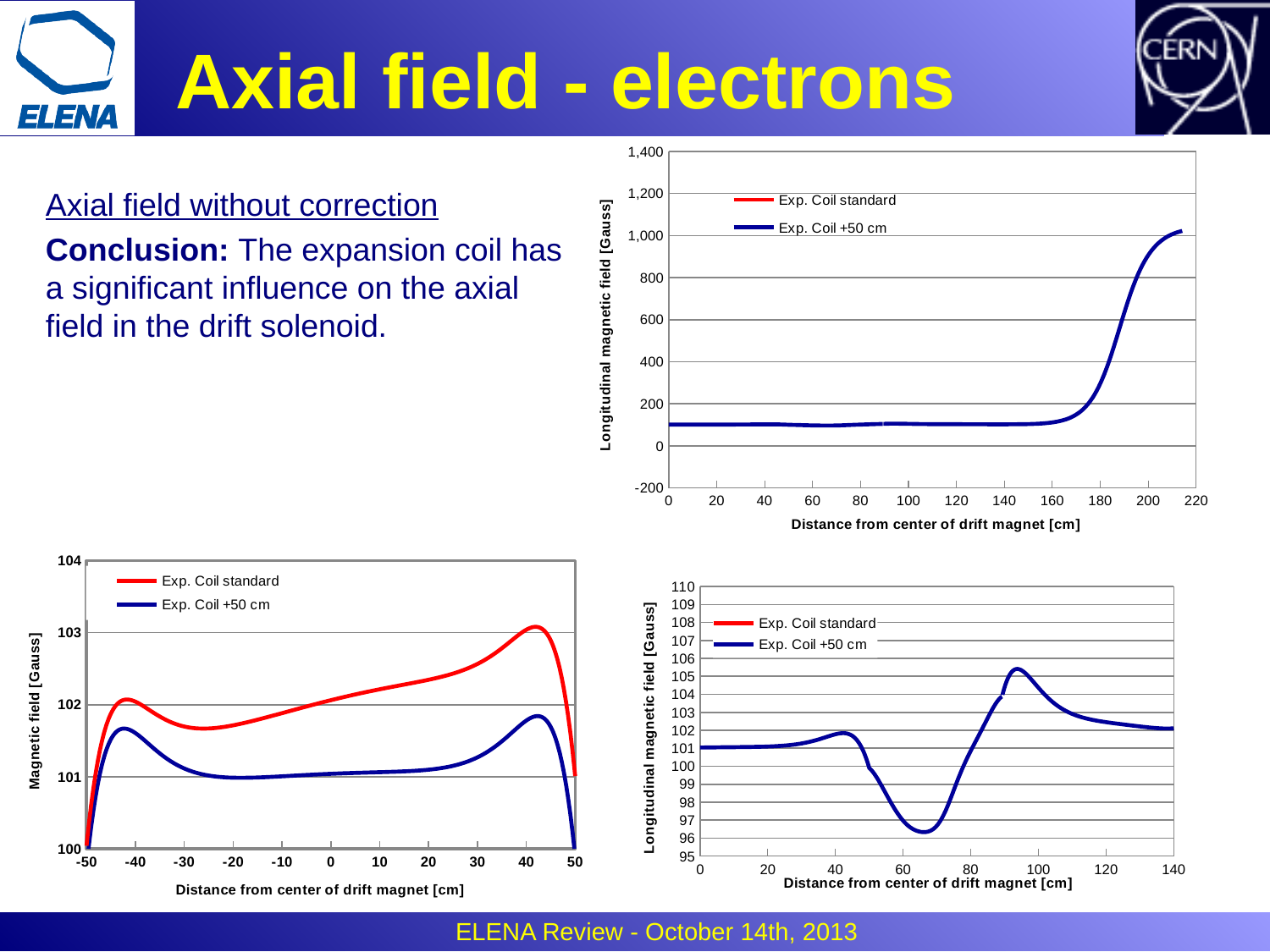
In the bottom-right chart, is the value at 60 cm greater or less than 100? less In the bottom-left chart, does the Exp. Coil standard line rise or fall between -20 cm and 40 cm? rise In the bottom-left chart, is the value of the Exp. Coil +50 cm line at 0 cm greater or less than 102? less In the bottom-right chart, does the curve rise or fall between 70 cm and 90 cm? rise In the top-right chart, is the value at 200 cm greater or less than 800? greater How many series does the legend of the bottom-left chart list? 2 What kind of chart is the chart at the top right of the slide? line chart What is the y-axis label of the bottom-left chart? Magnetic field [Gauss] In the top-right chart, does the curve rise or fall between 160 cm and 210 cm? rise